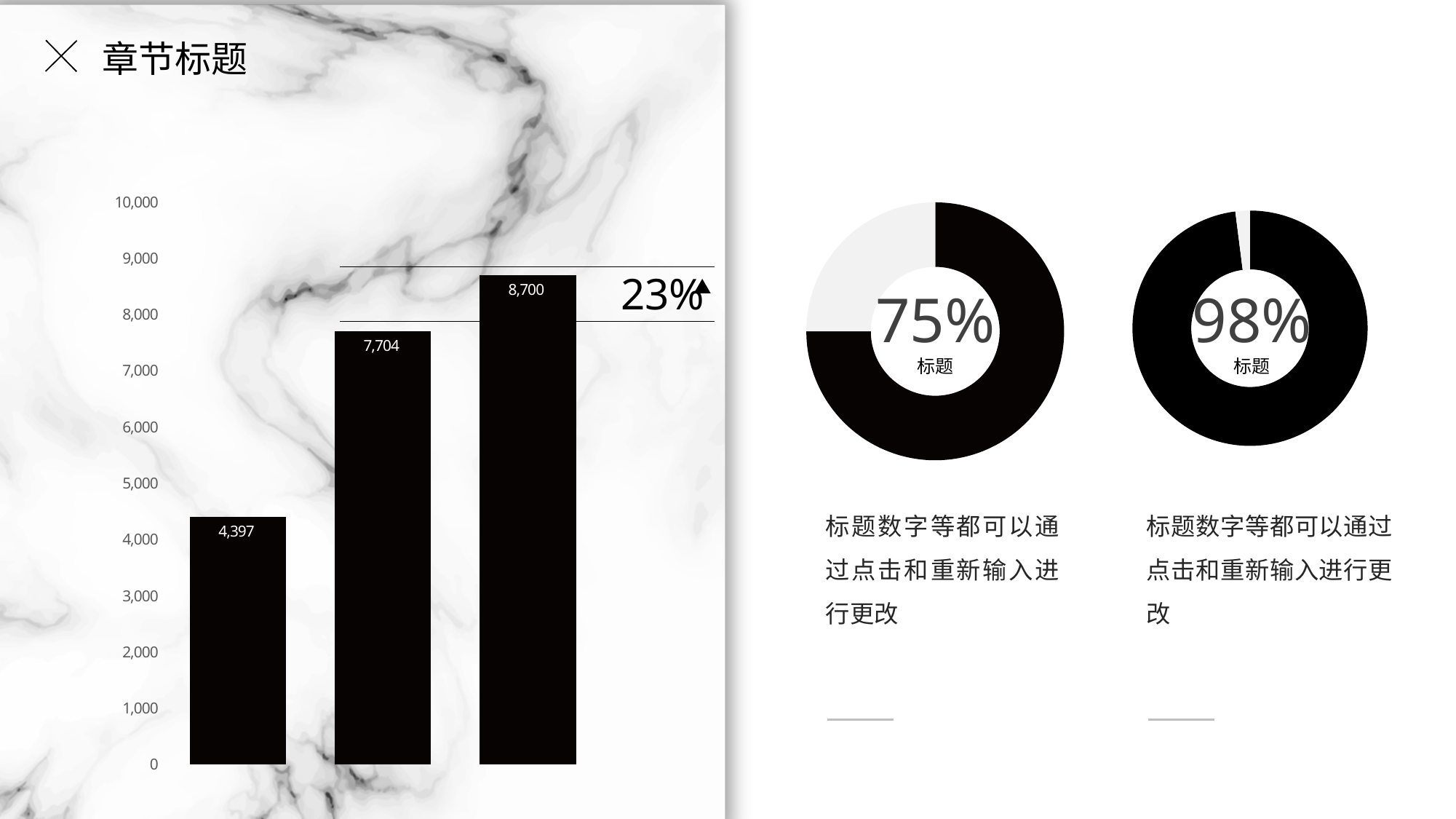
In the bar chart on the left, what is the value of the middle bar? 7,704 In the bar chart on the left, do the bar values rise or fall from left to right? rise In the bar chart on the left, how many bars are plotted? 3 In the bar chart on the left, what is the difference between the rightmost bar and the leftmost bar? 4,303 In the bar chart on the left, what is the value of the shortest bar? 4,397 In the bar chart on the left, what is the difference between the rightmost bar and the middle bar? 996 What percentage is shown in the centre of the right donut chart on the right side of the slide? 98% What percentage is shown in the centre of the left donut chart on the right side of the slide? 75% In the bar chart on the left, is the value of the middle bar greater or less than 7,000? greater In the bar chart on the left, what is the value of the leftmost bar? 4,397 What kind of chart is on the left side of the slide? bar chart In the bar chart on the left, what is the value of the tallest bar? 8,700